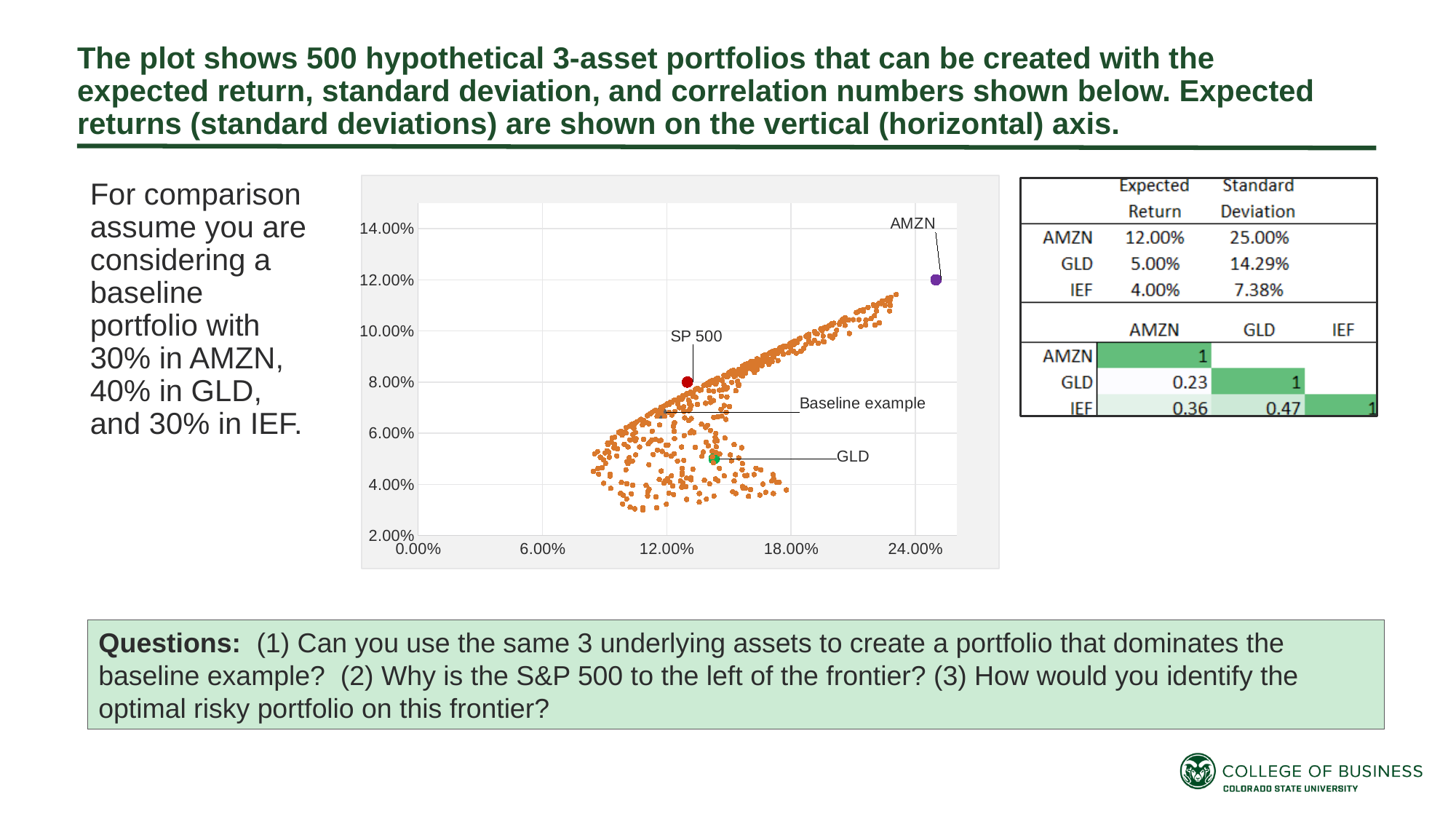
Which labeled point on the scatter plot has the lowest expected return? GLD What is the expected return of the AMZN point on the scatter plot? 12.00% Is the expected return of the GLD point greater or less than 6.00%? less What is the highest value shown on the vertical axis of the scatter plot? 14.00% How many hypothetical portfolios does the plot show, according to the slide title? 500 What kind of chart is shown on the slide? scatter plot Is the expected return of the SP 500 point greater or less than 6.00%? greater How many individually labeled points are called out on the scatter plot? 4 Which labeled point on the scatter plot has the highest expected return? AMZN Which labeled point on the scatter plot has the highest standard deviation (furthest right)? AMZN Is the standard deviation of the AMZN point greater or less than 24.00%? greater Which has the higher expected return on the scatter plot, the SP 500 point or the Baseline example point? SP 500